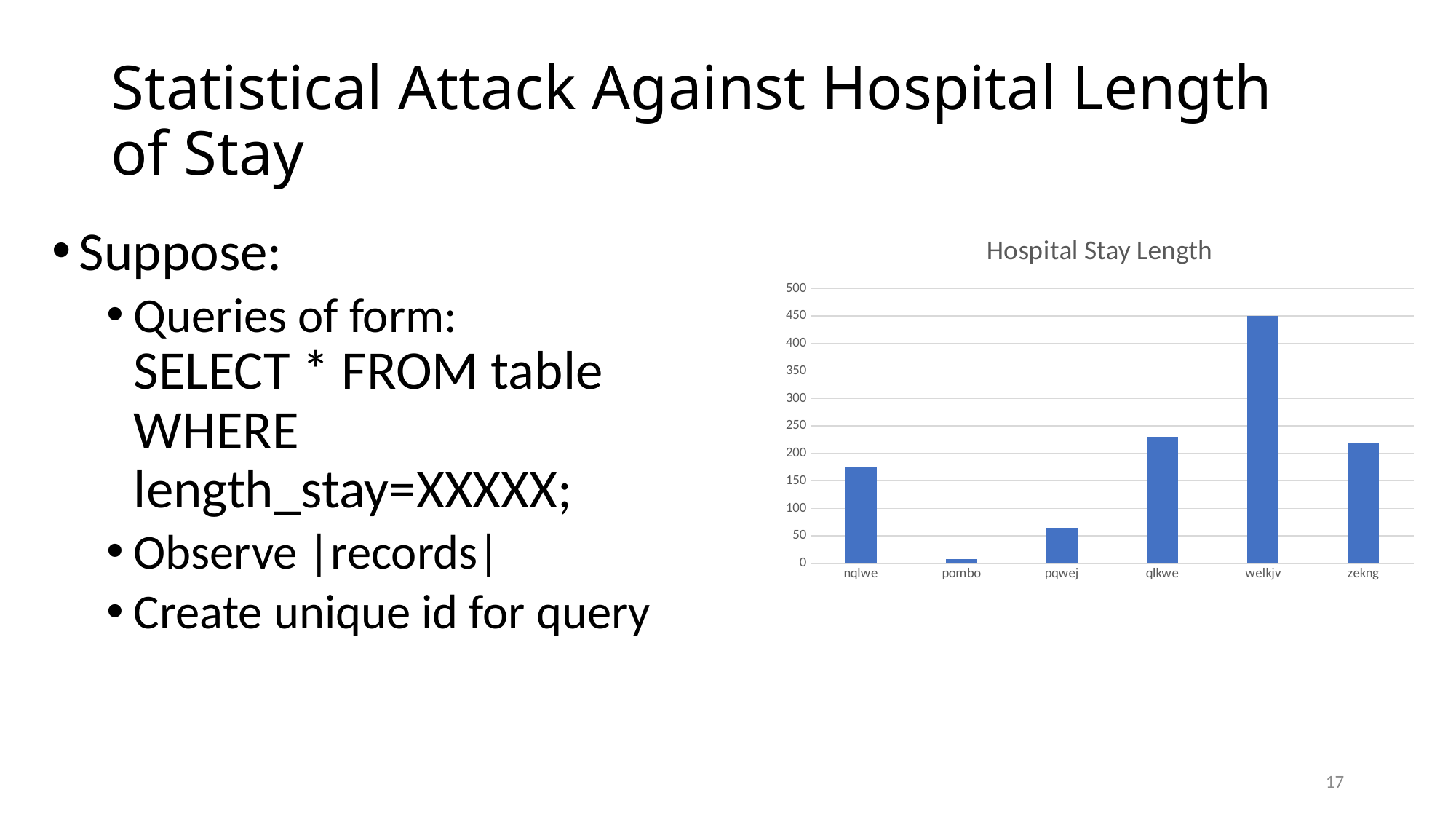
Which is larger in the Hospital Stay Length chart, the value for nqlwe or the value for pqwej? nqlwe Is the value for zekng greater or less than 250? less Is the value for pqwej greater or less than 100? less How many categories are shown on the x axis of the Hospital Stay Length chart? 6 Is the value for qlkwe greater or less than 200? greater What is the title of the chart? Hospital Stay Length Which category has the highest value in the Hospital Stay Length chart? welkjv What kind of chart is shown on the slide? bar chart Which category has the lowest value in the Hospital Stay Length chart? pombo